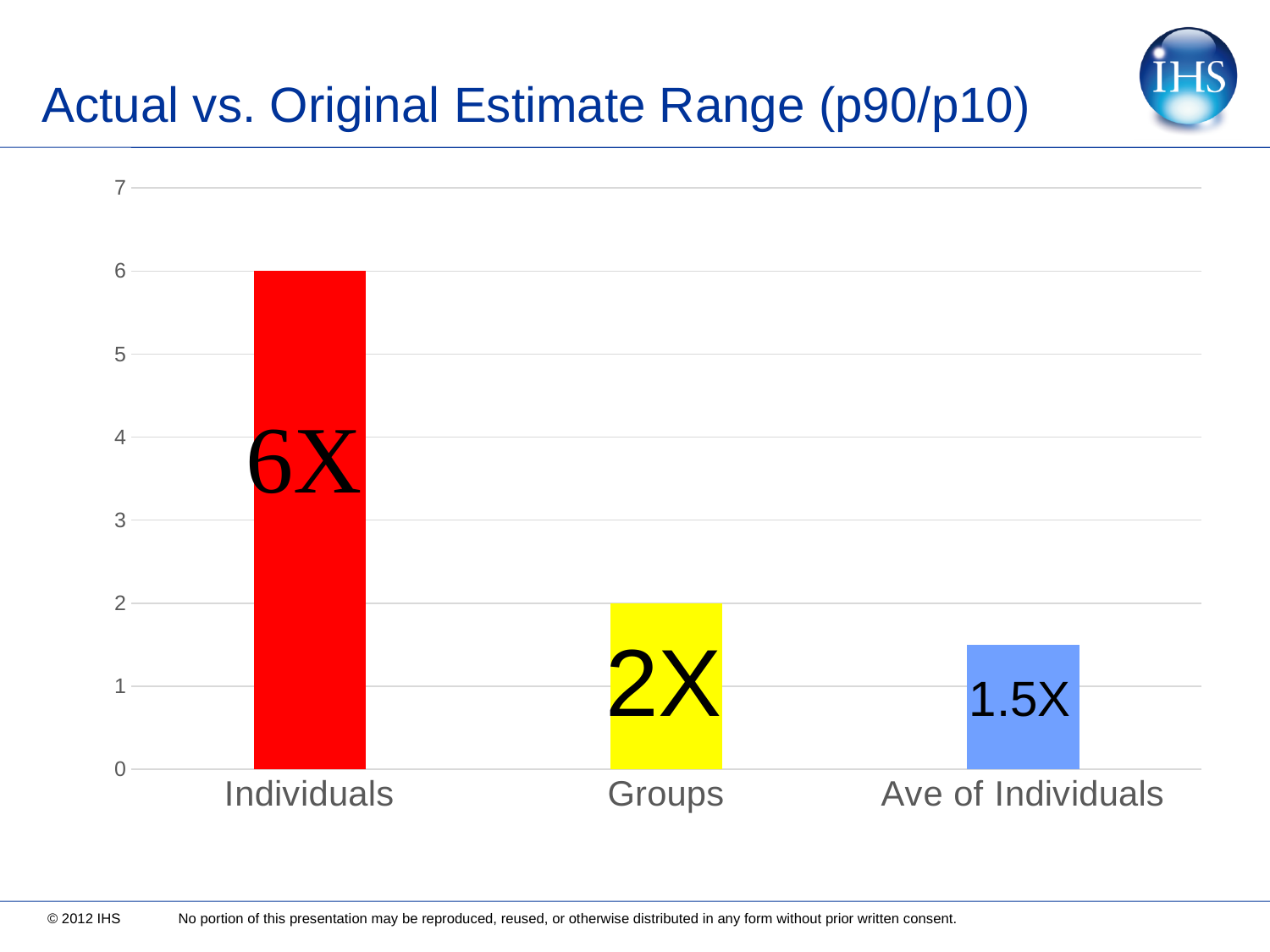
What is the difference between the values for Individuals and Groups? 4X Which is larger, the value for Groups or the value for Ave of Individuals? Groups What is the value shown for Individuals? 6X What kind of chart is shown on the slide? Bar chart How many categories are shown on the chart? 3 What is the difference between the values for Groups and Ave of Individuals? 0.5X What is the title of the chart? Actual vs. Original Estimate Range (p90/p10) Is the value for Individuals greater or less than 5? greater Which category has the highest value? Individuals Which category has the lowest value? Ave of Individuals What is the value shown for Groups? 2X What is the value shown for Ave of Individuals? 1.5X